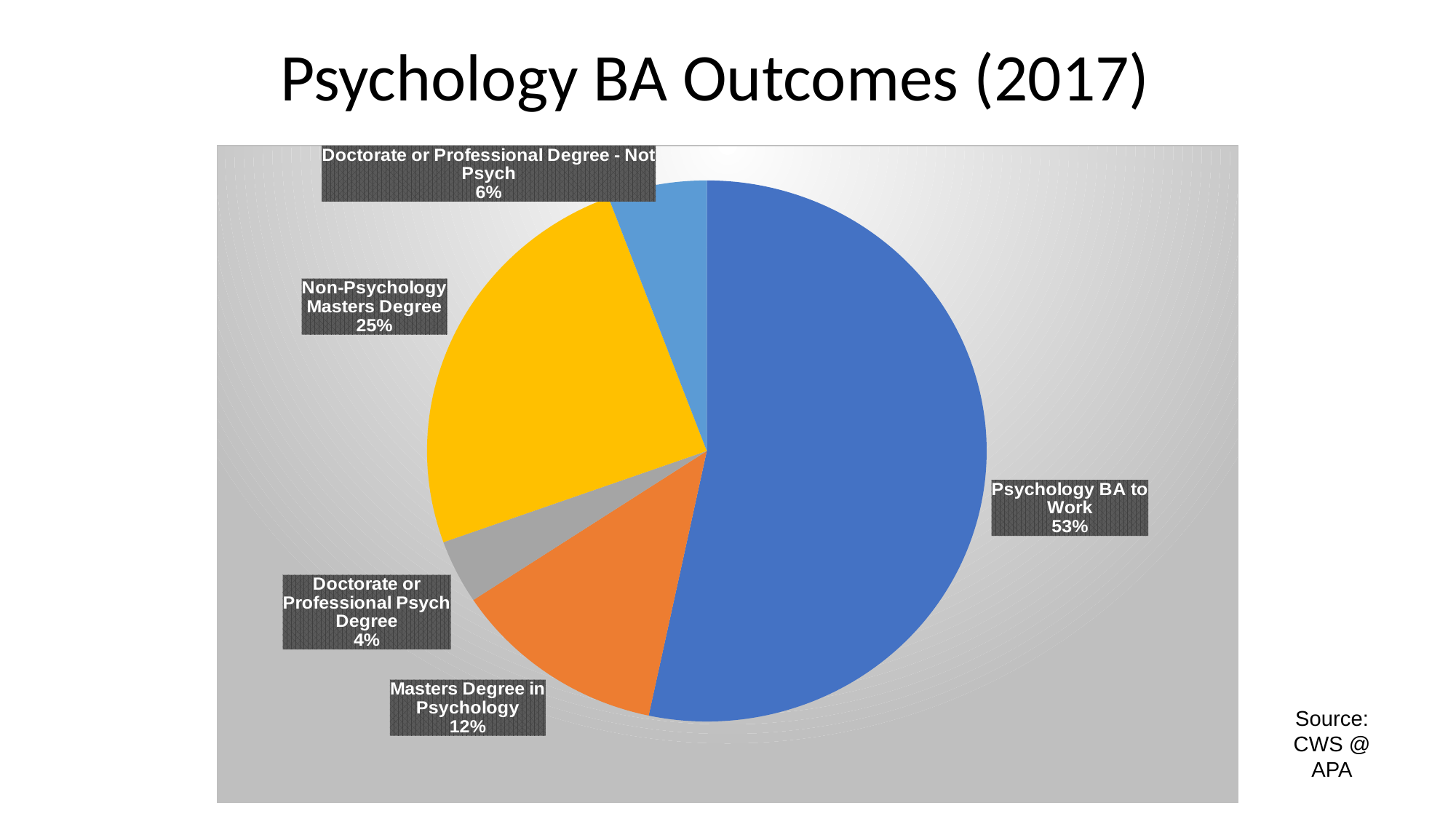
What kind of chart is shown on the slide? pie chart What percentage is shown for 'Doctorate or Professional Degree - Not Psych'? 6% Which is larger: 'Masters Degree in Psychology' or 'Doctorate or Professional Degree - Not Psych'? Masters Degree in Psychology Which outcome has the largest share of the pie? Psychology BA to Work What is the title of the chart on the slide? Psychology BA Outcomes (2017) What percentage is shown for 'Masters Degree in Psychology'? 12% What is the difference in percentage points between 'Psychology BA to Work' and 'Non-Psychology Masters Degree'? 28 Which outcome has the smallest share of the pie? Doctorate or Professional Psych Degree What share of the pie is 'Non-Psychology Masters Degree'? 25% How many slices does the pie chart have? 5 What percentage is shown for 'Doctorate or Professional Psych Degree'? 4% What percentage of Psychology BA outcomes is 'Psychology BA to Work'? 53%